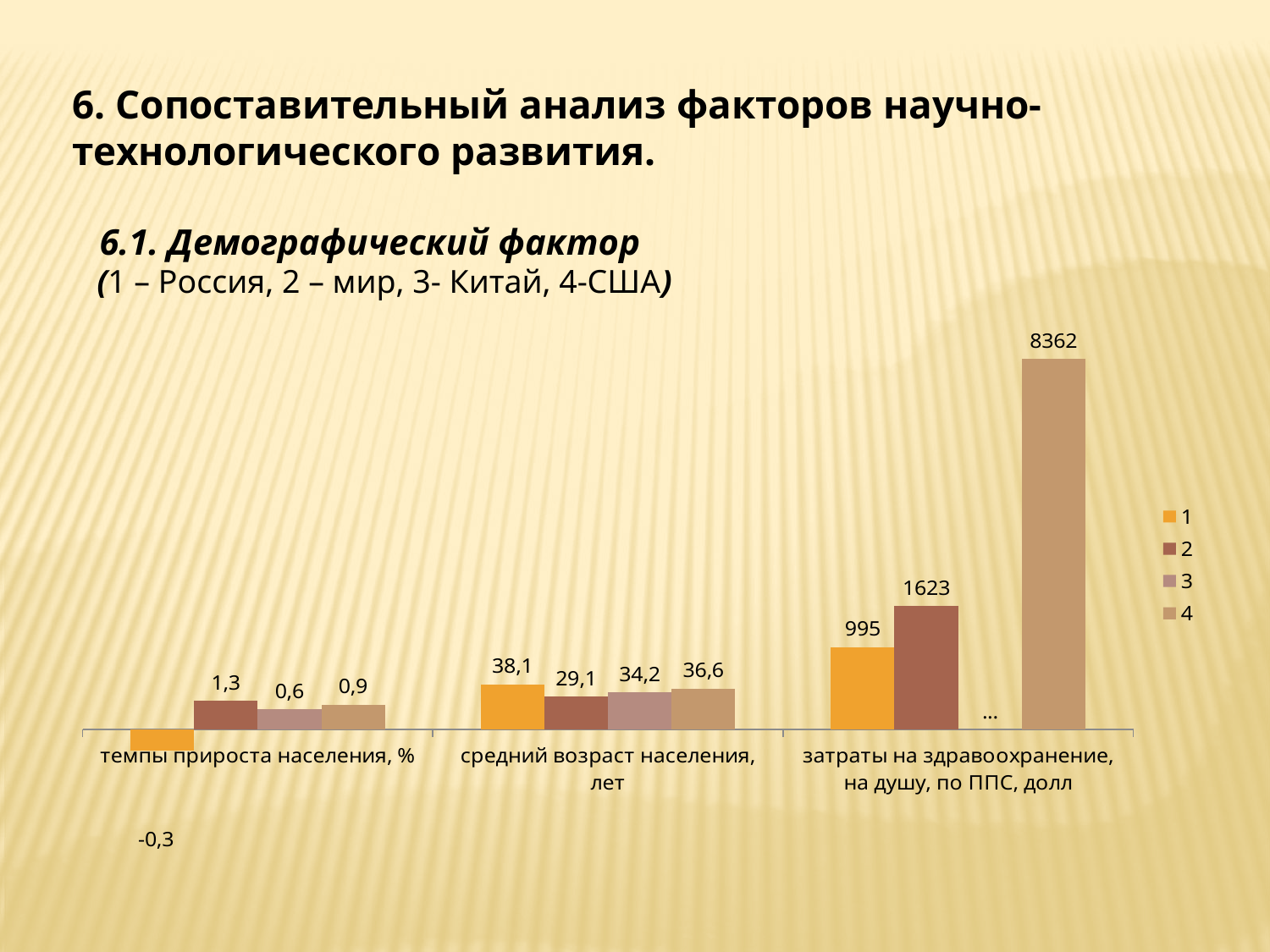
What kind of chart is shown on the slide? bar chart Which series has the highest value for 'средний возраст населения, лет'? 1 Which series has the lowest value for 'темпы прироста населения, %'? 1 What is the value of series 2 for 'средний возраст населения, лет'? 29,1 How many series does the legend list? 4 What is the difference between series 1 and series 2 for 'средний возраст населения, лет'? 9 What is the value of series 1 for 'темпы прироста населения, %'? -0,3 What is the value of series 4 for 'затраты на здравоохранение, на душу, по ППС, долл'? 8362 What is the value of series 3 for 'темпы прироста населения, %'? 0,6 For 'средний возраст населения, лет', which is larger: series 3 or series 4? 4 What is the difference between series 2 and series 1 for 'затраты на здравоохранение, на душу, по ППС, долл'? 628 How many categories are shown on the x axis? 3